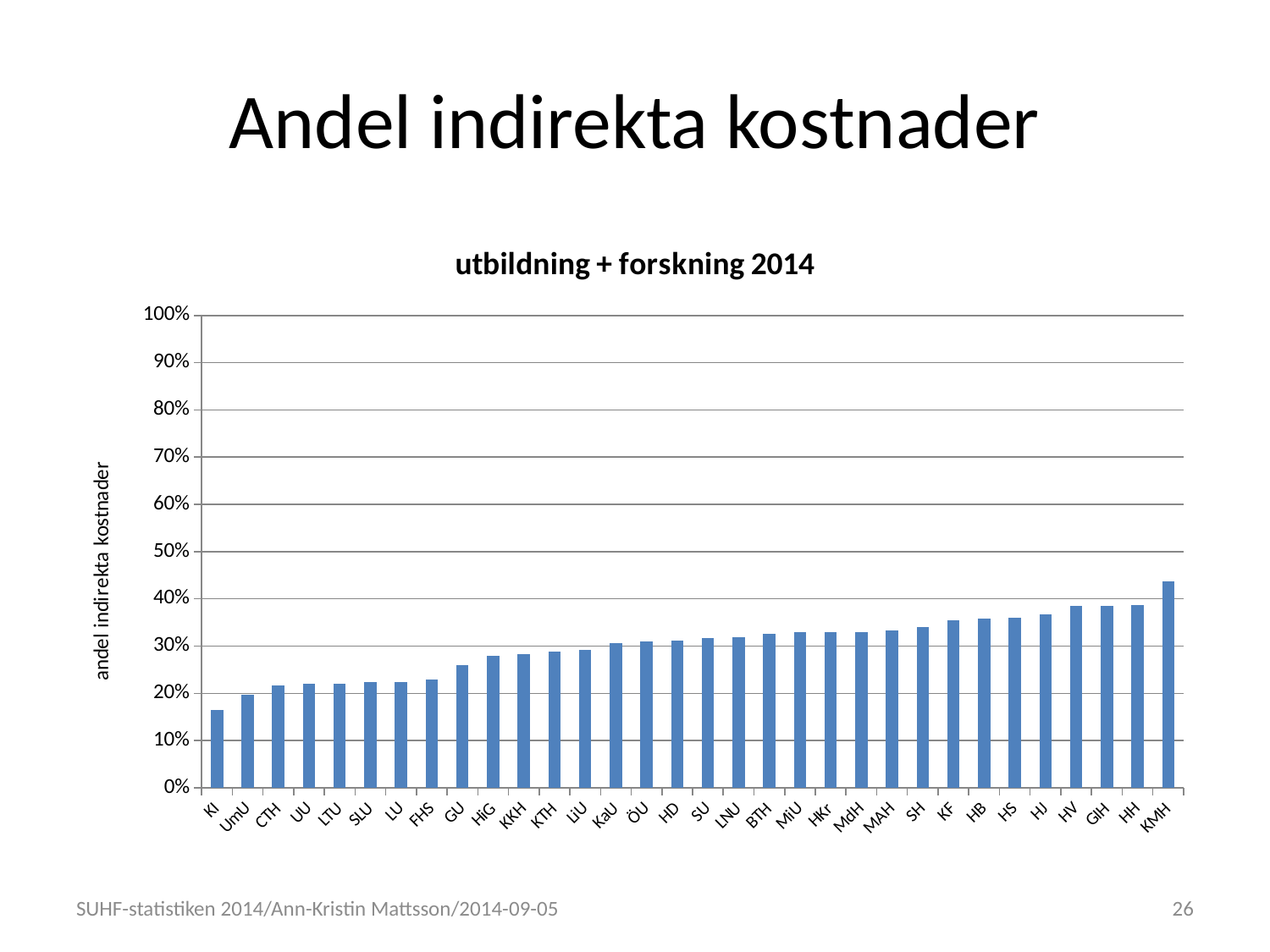
Which category has the highest value? KMH Is the value for GU greater or less than 30%? less Do the values rise or fall moving from left to right along the x axis? rise Is the value for HV greater or less than 30%? greater What kind of chart is shown on the slide? bar chart How many categories (institutions) are shown on the x axis? 32 Which has the larger value, CTH or HB? HB Which category has the lowest value? KI What is the title of the chart? utbildning + forskning 2014 Is the value for KI greater or less than 20%? less What is the label on the vertical axis of the chart? andel indirekta kostnader